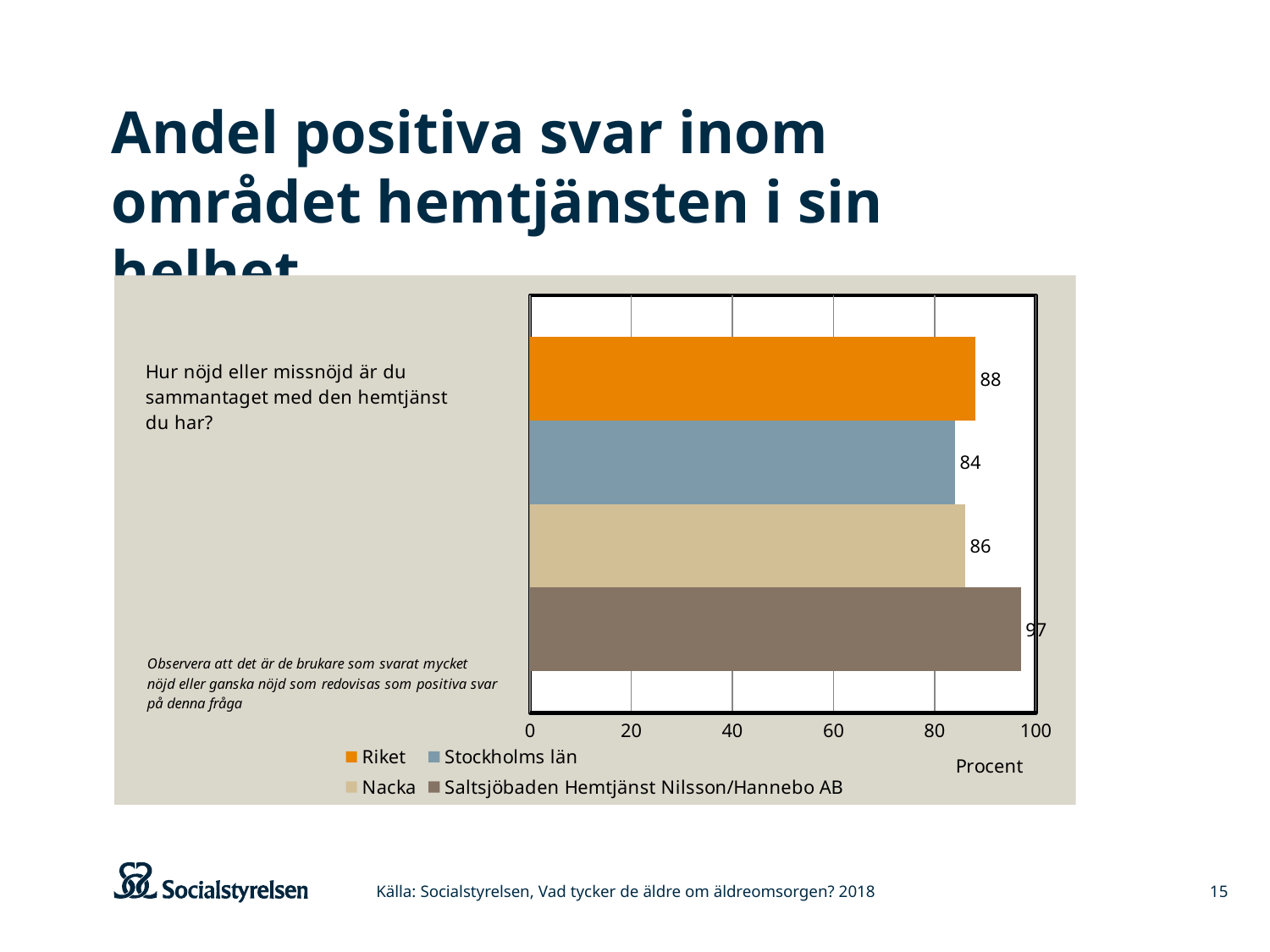
What is the value for Saltsjöbaden Hemtjänst Nilsson/Hannebo AB? 97 What is the value for Nacka? 86 What is the difference between the values for Saltsjöbaden Hemtjänst Nilsson/Hannebo AB and Riket? 9 What is the value for Riket? 88 Which series has the lowest value? Stockholms län What is the label of the horizontal axis? Procent What kind of chart is shown on the slide? bar chart Which is larger, the value for Riket or the value for Nacka? Riket Is the value for Stockholms län greater or less than 80? greater How many series does the legend list? 4 Which series has the highest value? Saltsjöbaden Hemtjänst Nilsson/Hannebo AB What is the value for Stockholms län? 84